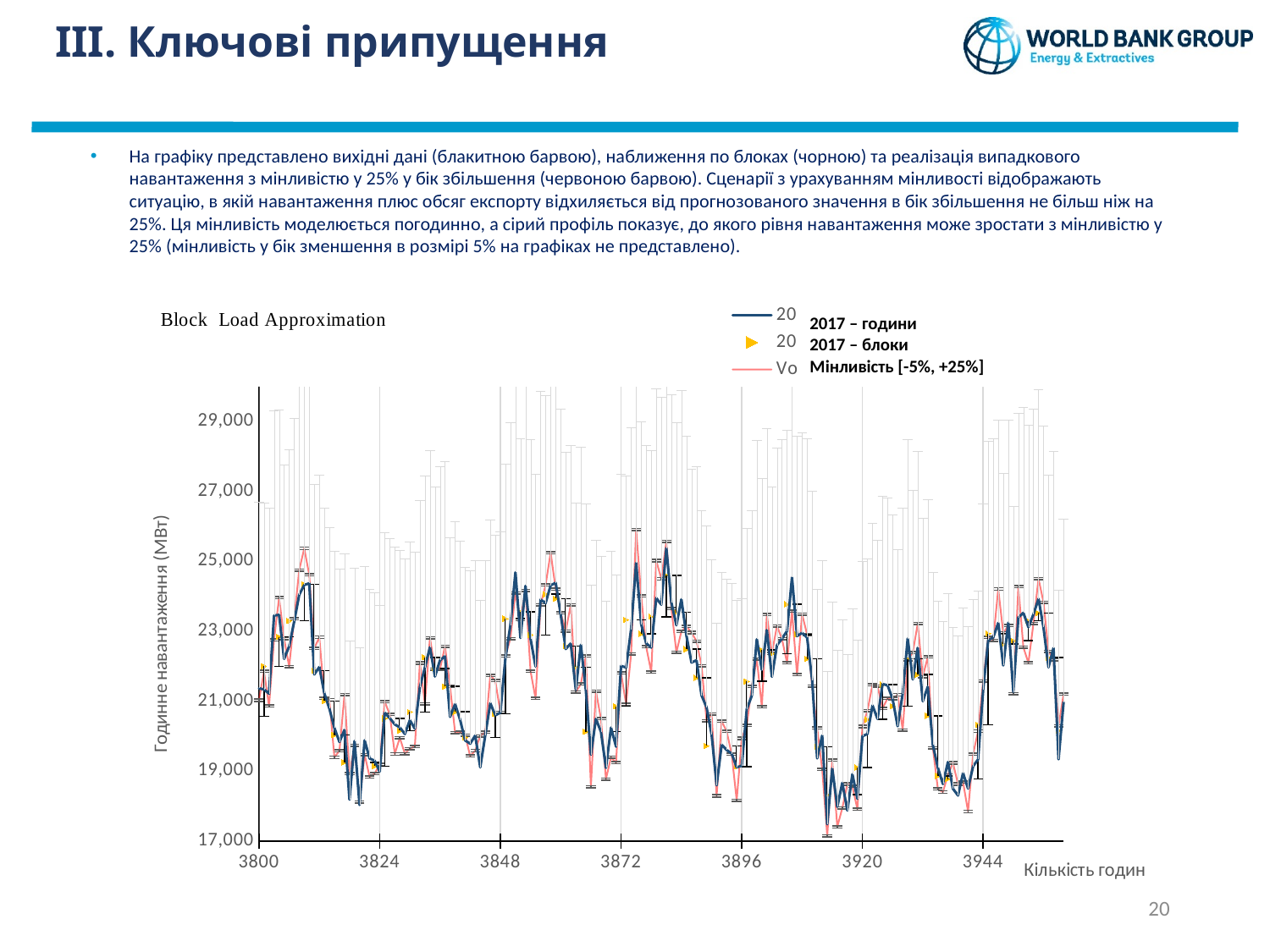
How many tick labels are shown on the x axis of the chart? 7 What is the lowest value shown on the y axis of the chart? 17,000 What is the label of the y axis of the chart? Годинне навантаження (МВт) What is the last tick value on the x axis of the chart? 3944 Is the peak of the '2017 – години' series between hours 3800 and 3824 greater or less than 23,000? greater How many series does the chart legend list? 3 Which series reaches higher peak values, '2017 – години' or 'Мінливість [-5%, +25%]'? Мінливість [-5%, +25%] What is the title of the chart? Block Load Approximation What is the first tick value on the x axis of the chart? 3800 What kind of chart is shown on the slide? Line chart What is the highest value shown on the y axis of the chart? 29,000